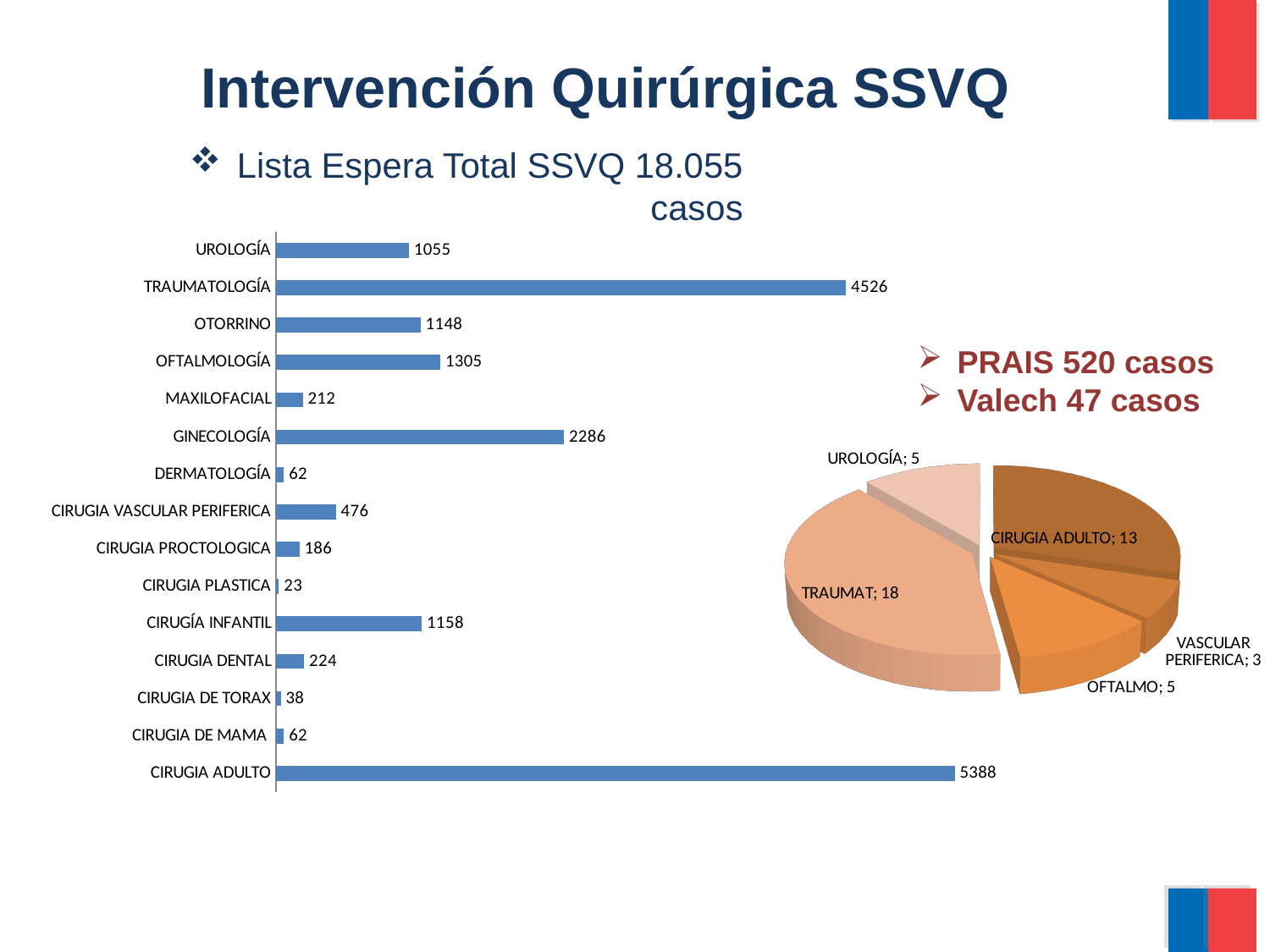
In the pie chart on the right, which slice has the smallest value? VASCULAR PERIFERICA In the pie chart on the right, what is the value for TRAUMAT? 18 In the pie chart on the right, which slice has the largest value? TRAUMAT In the bar chart on the left, what is the value for TRAUMATOLOGÍA? 4526 What type of chart is the chart on the left? bar chart How many categories are shown in the bar chart on the left? 15 In the bar chart on the left, which category has the lowest value? CIRUGIA PLASTICA In the bar chart on the left, what is the value for GINECOLOGÍA? 2286 In the bar chart on the left, which is larger, OFTALMOLOGÍA or OTORRINO? OFTALMOLOGÍA In the bar chart on the left, which category has the highest value? CIRUGIA ADULTO In the bar chart on the left, what is the difference between CIRUGIA ADULTO and TRAUMATOLOGÍA? 862 How many slices does the pie chart on the right have? 5